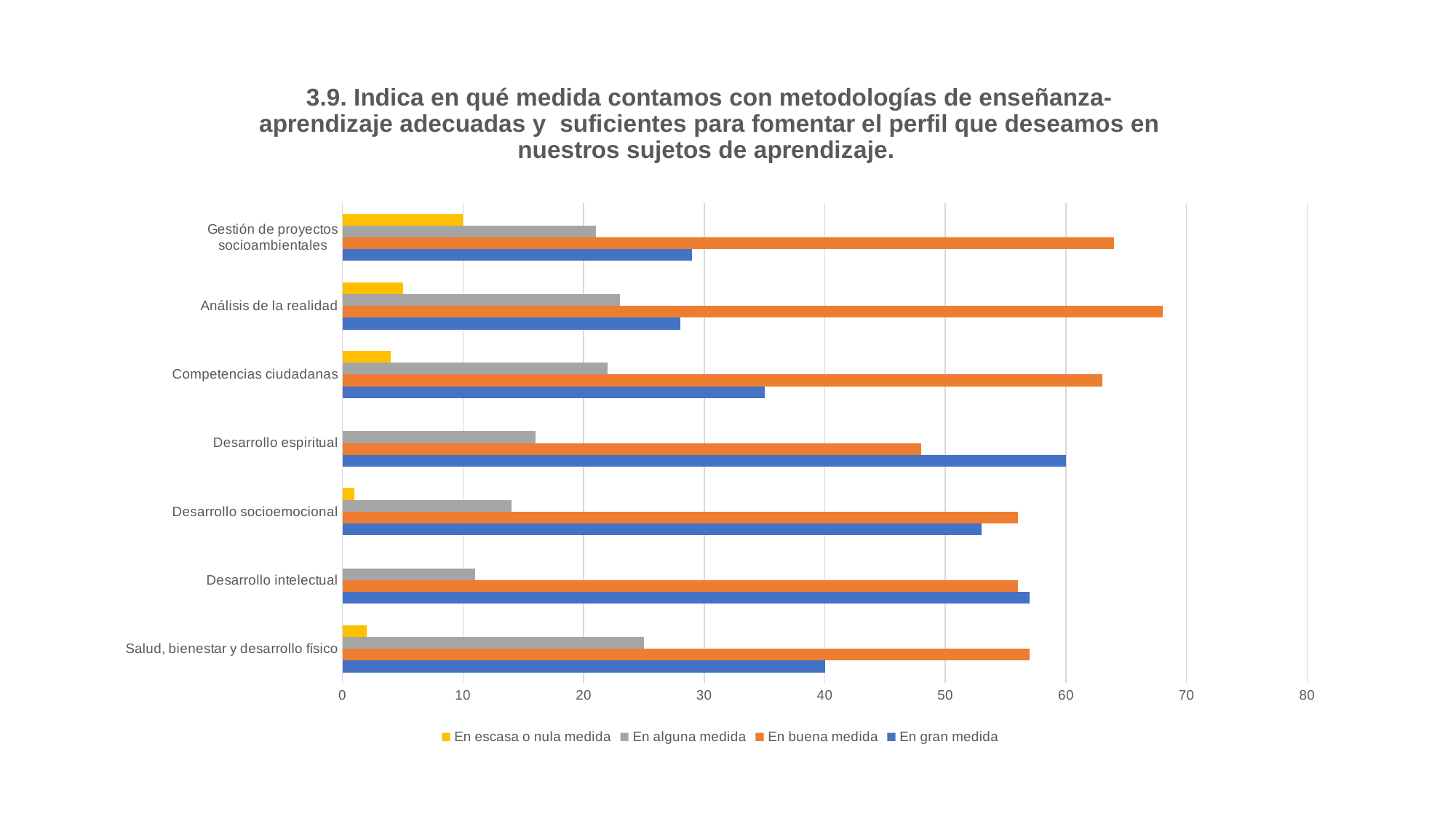
Is the value of 'En alguna medida' for Desarrollo socioemocional greater or less than 20? less How many series does the legend list? 4 For Competencias ciudadanas, which is larger: 'En buena medida' or 'En gran medida'? En buena medida Is the value of 'En alguna medida' for Salud, bienestar y desarrollo físico greater or less than 20? greater What is the value of 'En gran medida' for Desarrollo espiritual? 60 What kind of chart is shown on the slide? bar chart What is the value of 'En gran medida' for Salud, bienestar y desarrollo físico? 40 Which category has the highest value for 'En buena medida'? Análisis de la realidad How many categories are plotted on the vertical axis? 7 Is the value of 'En buena medida' for Análisis de la realidad greater or less than 60? greater Which category has the highest value for 'En gran medida'? Desarrollo espiritual What colour represents the series 'En gran medida' in the legend? blue